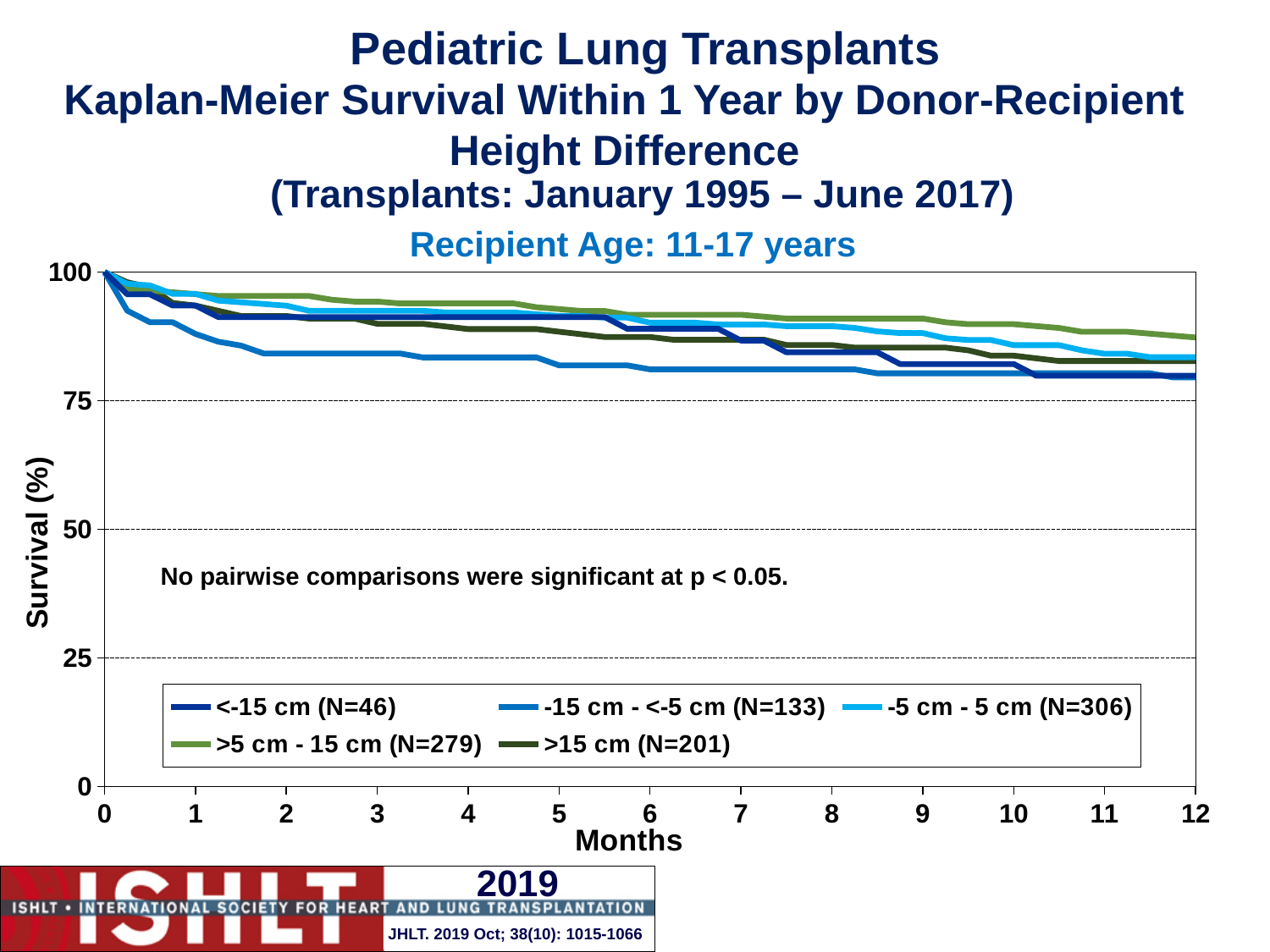
At 12 months, which group has higher survival: >5 cm - 15 cm or <-15 cm? >5 cm - 15 cm What kind of chart is shown on the slide? Line chart Do the survival curves rise or fall as months increase? Fall What is the N for the -5 cm - 5 cm group in the legend? 306 Which group has the lowest survival at month 2? -15 cm - <-5 cm (N=133) Is the survival for the <-15 cm group at 12 months greater or less than 75? greater What is the maximum value shown on the x axis (Months)? 12 What is the survival value for all groups at month 0? 100 Is the survival for the >5 cm - 15 cm group at 12 months greater or less than 75? greater Which group has the highest survival at 12 months? >5 cm - 15 cm (N=279) How many series does the legend list? 5 What recipient age range is stated in the chart subtitle? 11-17 years